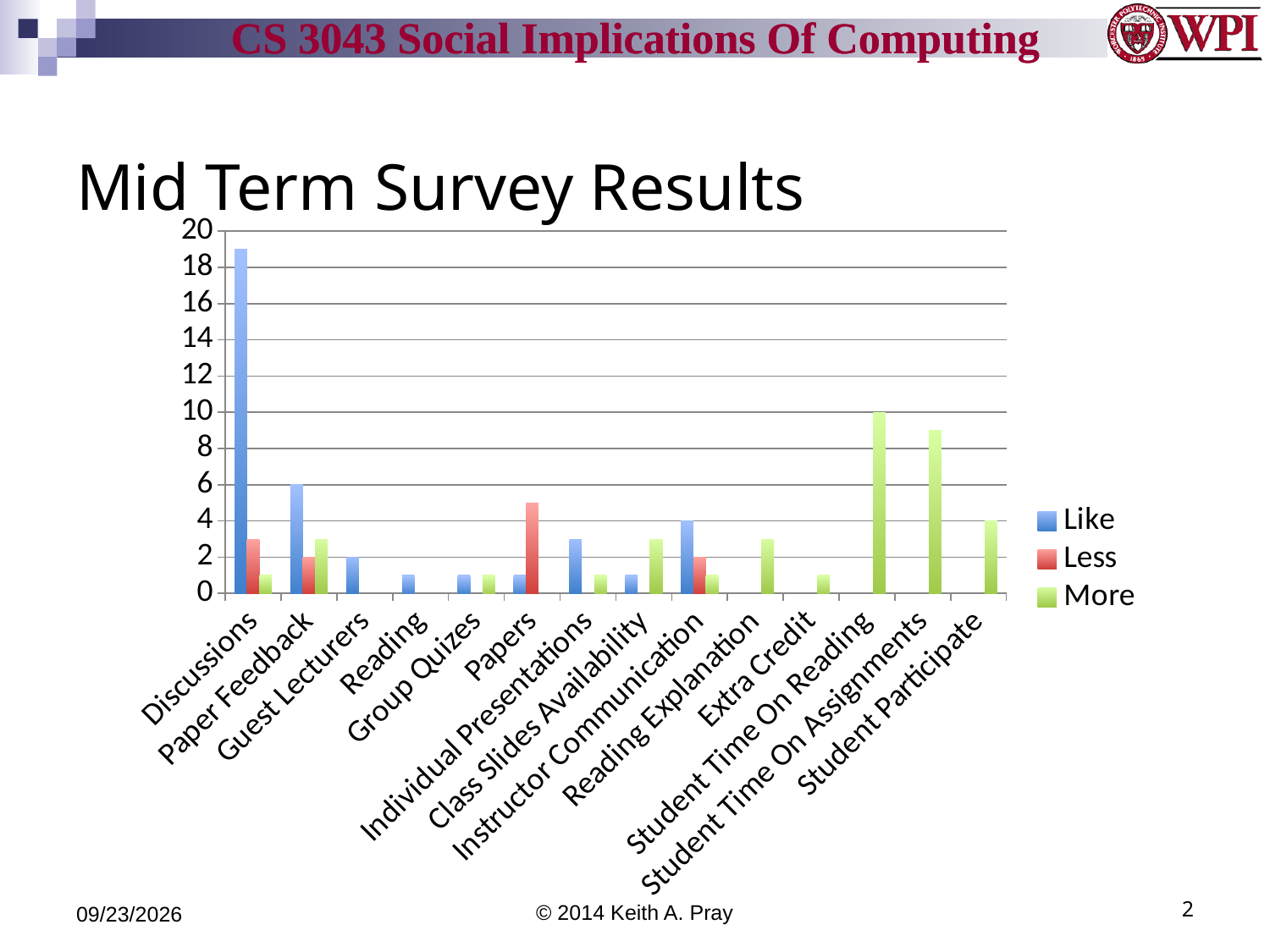
What kind of chart is shown on the slide? bar chart What is the Like value for Guest Lecturers? 2 What is the Like value for Paper Feedback? 6 Which category has the highest Less value? Papers How many series does the legend list? 3 Is the Like value for Discussions greater or less than 18? greater What is the Like value for Instructor Communication? 4 How many categories are shown on the x axis? 14 Is the More value for Student Time On Assignments greater or less than 8? greater What is the More value for Student Time On Reading? 10 Which category has the highest Like value? Discussions Which is larger, the More value for Student Time On Reading or the More value for Student Participate? Student Time On Reading